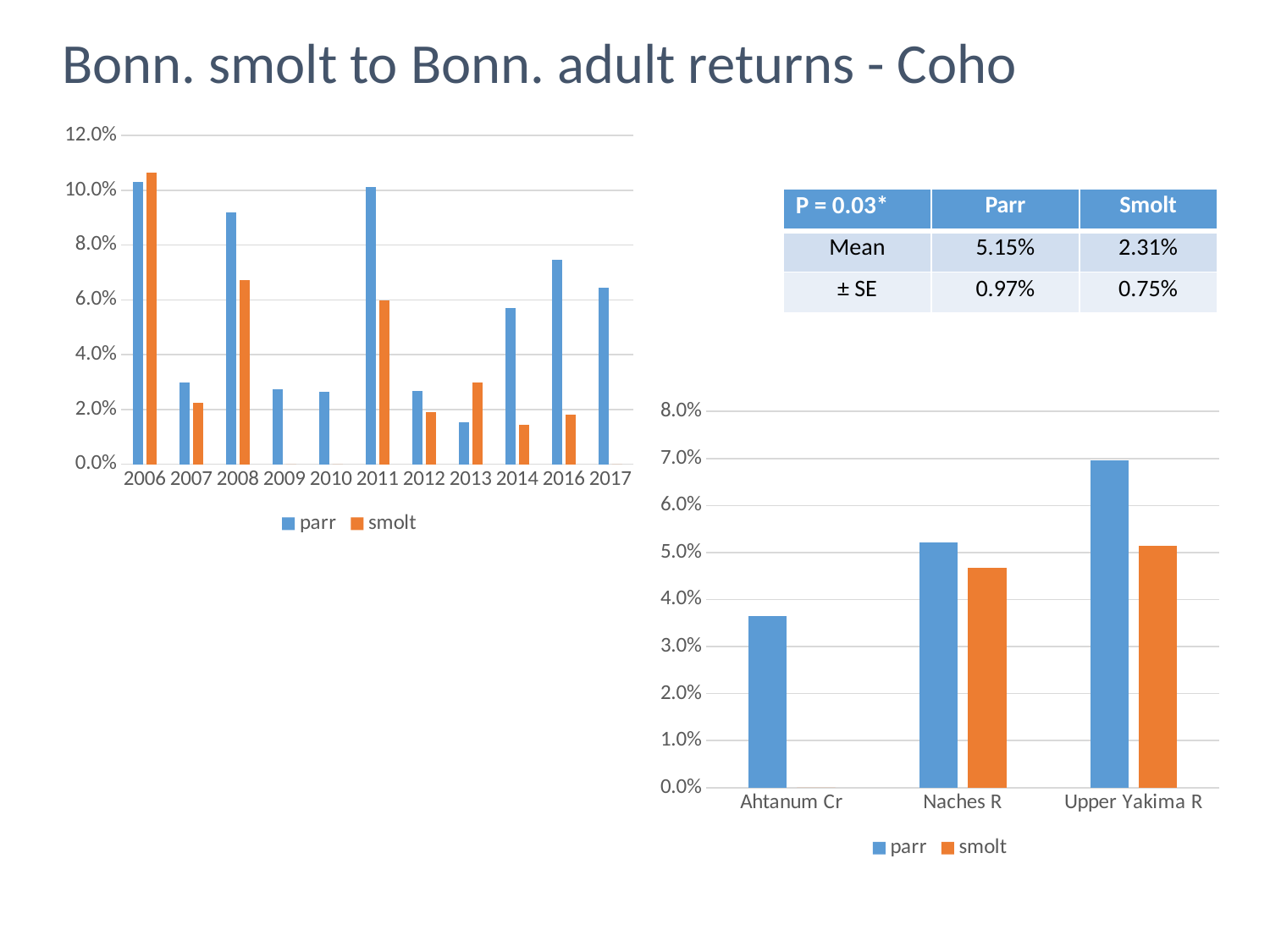
On the left chart (by year), is the parr value for 2008 greater or less than 8.0%? greater On the right chart (by river), which category has the highest parr value? Upper Yakima R On the left chart (by year), is the smolt value for 2006 greater or less than 10.0%? greater On the right chart (by river), is the parr value for Ahtanum Cr greater or less than 4.0%? less On the left chart (by year), how many series does the legend list? 2 On the left chart (by year), which is larger in 2013, the parr value or the smolt value? smolt On the right chart (by river), how many categories are shown on the x axis? 3 On the left chart (by year), which year has the highest smolt value? 2006 On the left chart (by year), how many years are shown on the x axis? 11 On the right chart (by river), what kind of chart is it? bar chart On the left chart (by year), which year has the lowest parr value? 2013 On the right chart (by river), which is larger for Naches R, the parr value or the smolt value? parr